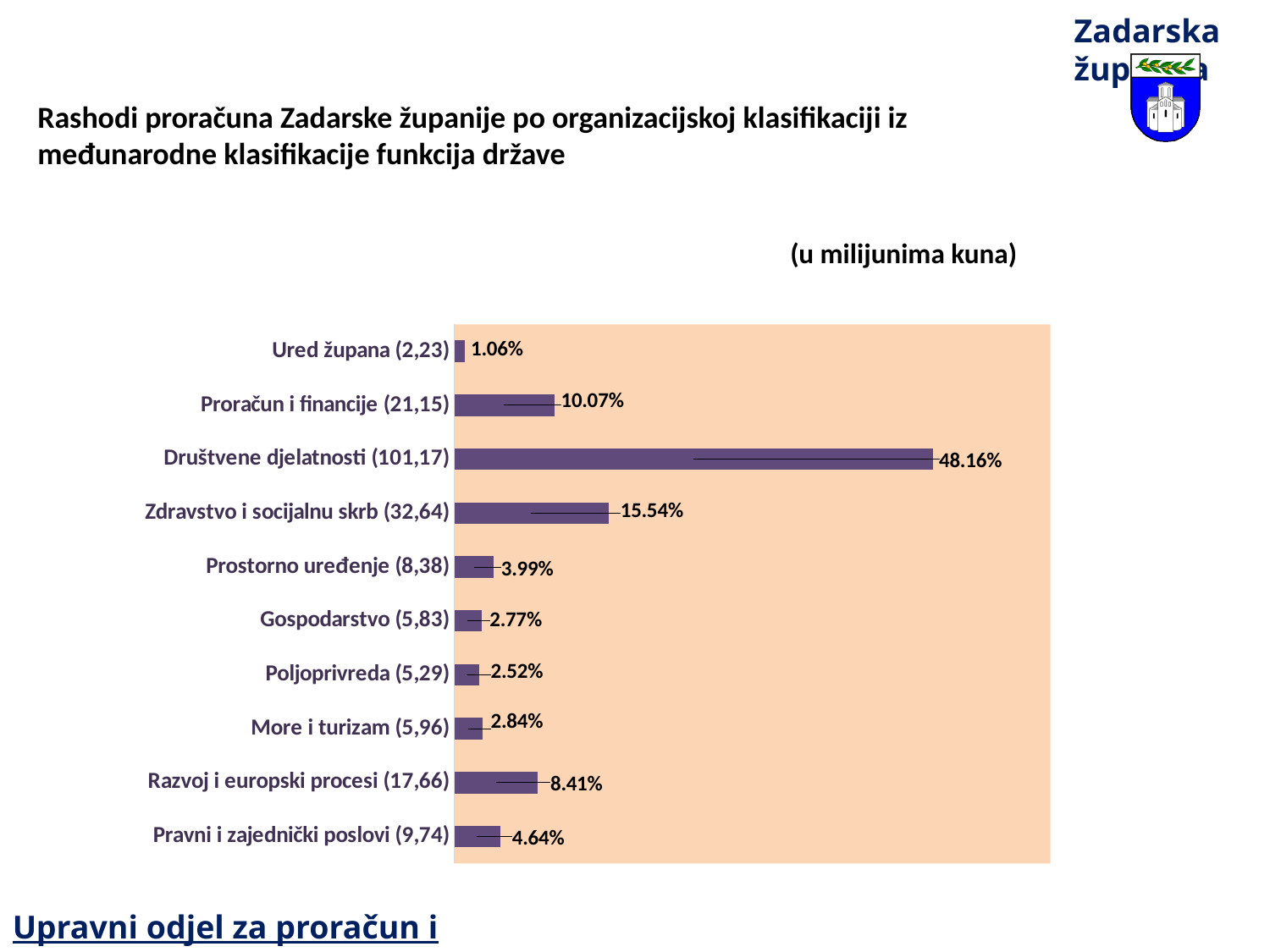
Which category has the highest percentage? Društvene djelatnosti Which category has the lowest percentage? Ured župana What is the difference in percentage points between Društvene djelatnosti and Zdravstvo i socijalnu skrb? 32.62% What percentage is shown for Ured župana? 1.06% What percentage is shown for Zdravstvo i socijalnu skrb? 15.54% Which has a larger percentage, Prostorno uređenje or Pravni i zajednički poslovi? Pravni i zajednički poslovi What is the difference in percentage points between Proračun i financije and Razvoj i europski procesi? 1.66% What percentage is shown for Društvene djelatnosti? 48.16% What percentage is shown for Razvoj i europski procesi? 8.41% How many categories are shown in the chart? 10 What kind of chart is shown on the slide? Bar chart What unit is stated in parentheses above the chart? u milijunima kuna